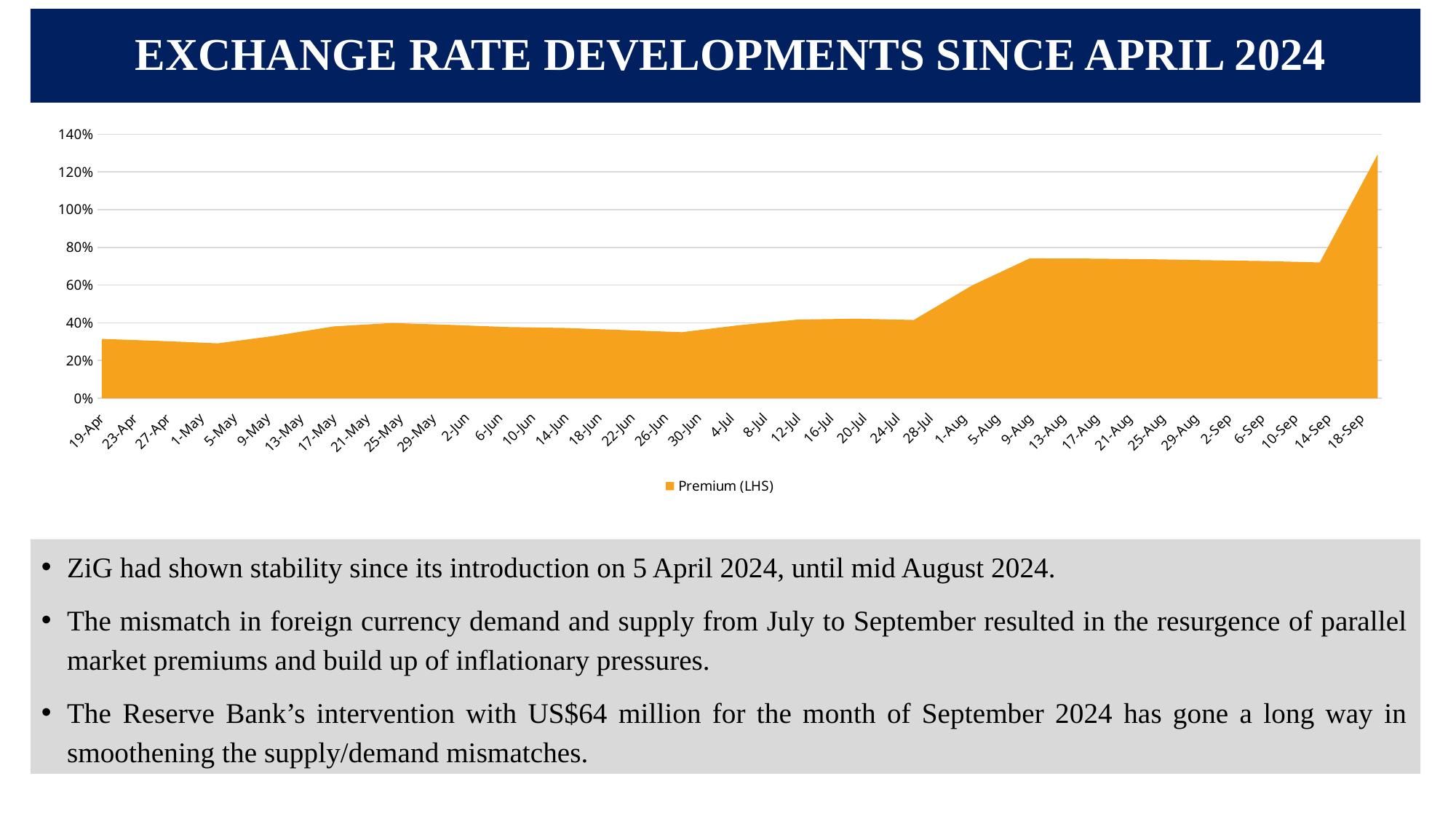
Is the value for 9-Aug greater or less than 60%? greater Is the value for 19-Apr greater or less than 20%? greater Which date has the larger premium, 9-Aug or 24-Jul? 9-Aug What is the highest value shown on the vertical axis? 140% Is the value for 5-May greater or less than 40%? less What is the name of the series shown in the legend? Premium (LHS) How many series does the legend list? 1 Does the premium overall rise or fall from 19-Apr to 18-Sep? rise What kind of chart is shown on the slide? Area chart